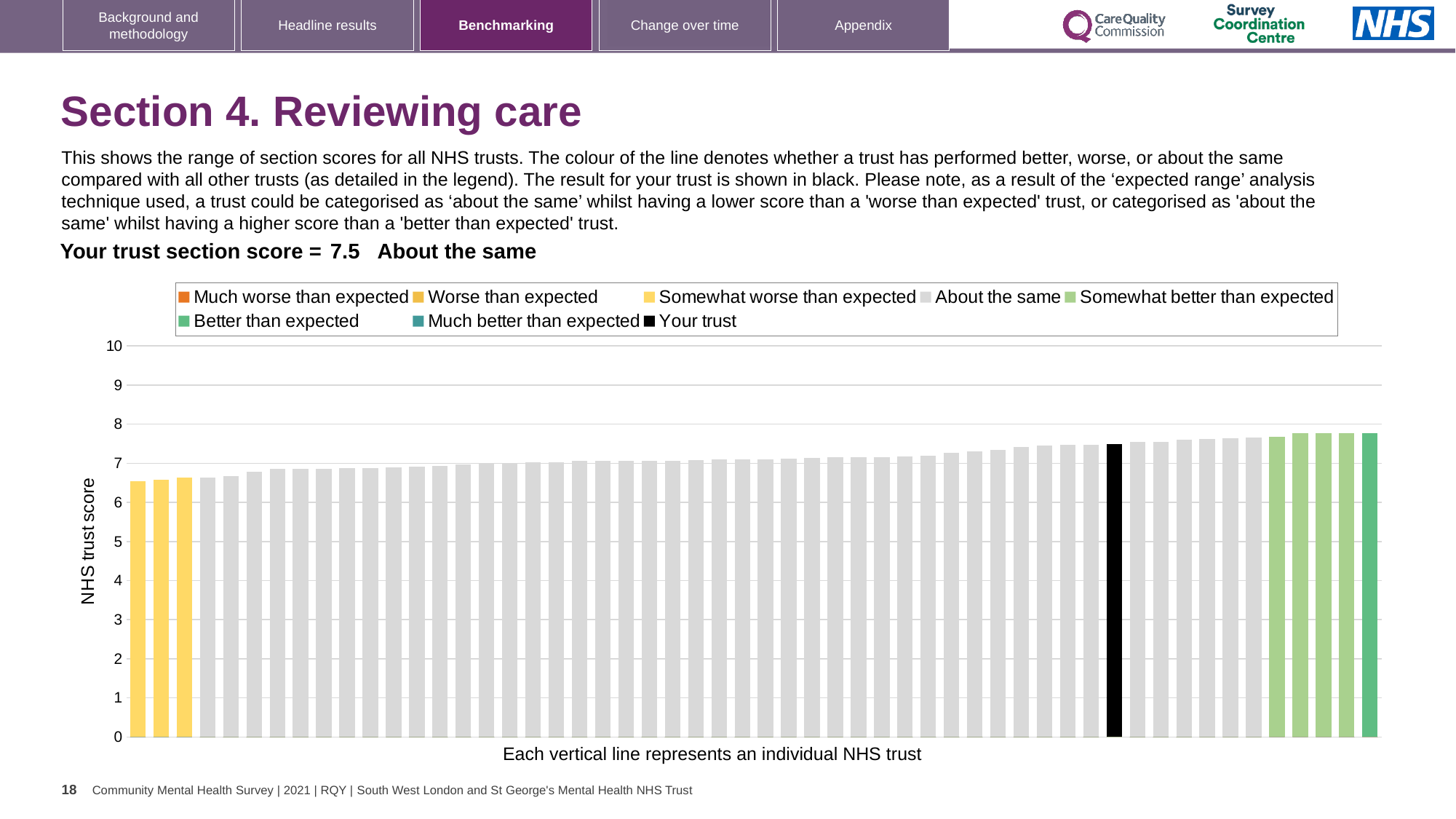
Is the value of the black 'Your trust' bar greater or less than 7? greater What is the label on the vertical axis of the chart? NHS trust score What kind of chart is shown on the slide? bar chart Do the bar values rise or fall from left to right along the x axis? rise What is the section score for your trust shown on the slide? 7.5 How many bars are coloured yellow (Somewhat worse than expected)? 3 How many entries does the chart legend list? 8 What colour is the bar representing your trust? black Is the value of the rightmost (highest) bar greater or less than 8? less Which category is your trust placed in for this section? About the same Is the value of the black 'Your trust' bar greater or less than 8? less